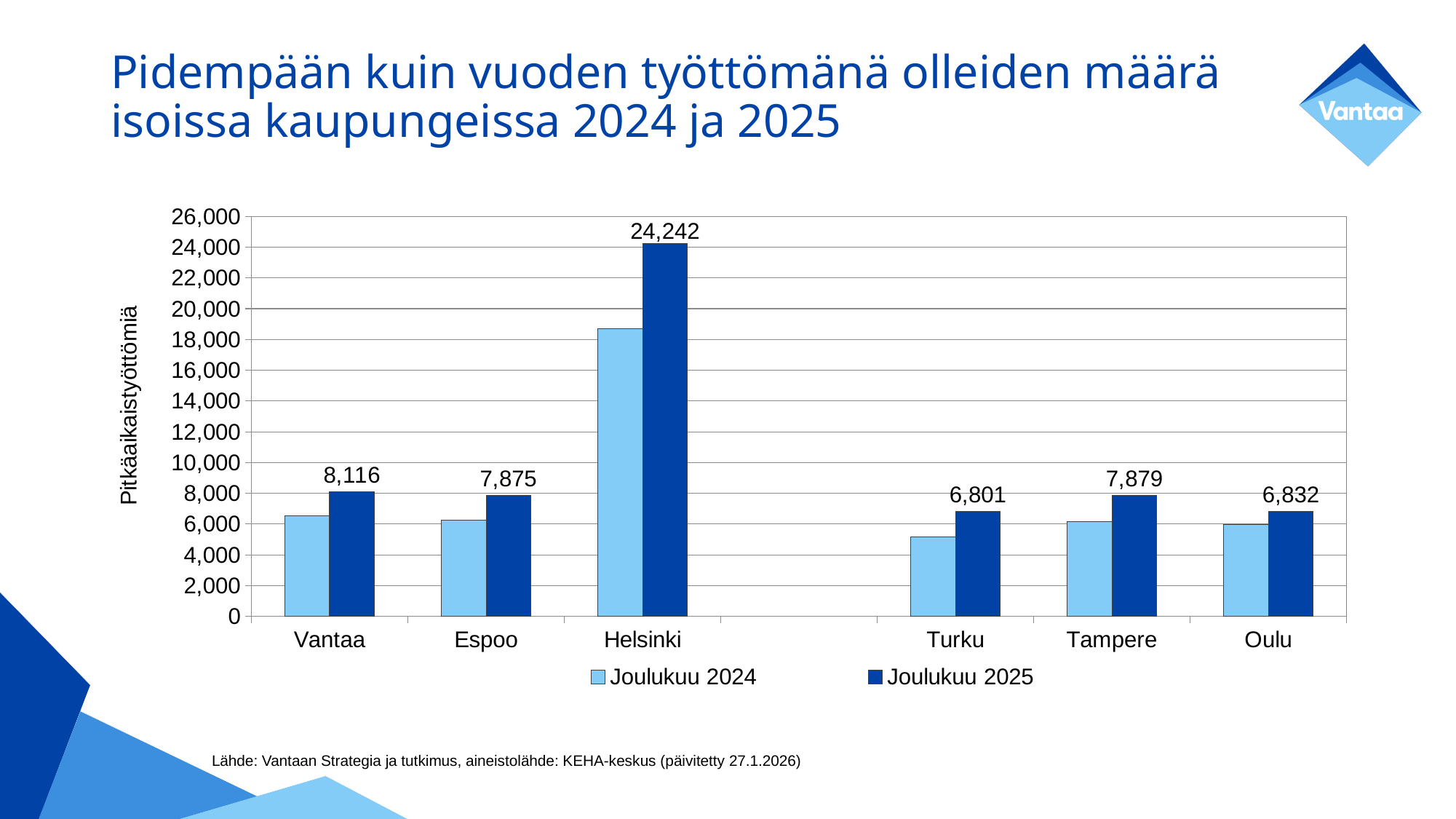
Which city has the lowest value in the Joulukuu 2025 series? Turku How many cities are shown on the x axis of the chart? 6 Is the Joulukuu 2024 value for Helsinki greater or less than 18,000? greater Which city has the highest value in the Joulukuu 2025 series? Helsinki What is the difference between the Joulukuu 2025 values for Helsinki and Vantaa? 16,126 Which is larger in the Joulukuu 2025 series, Tampere or Espoo? Tampere Is the Joulukuu 2024 value for Turku greater or less than 6,000? less What is the value for Helsinki in the Joulukuu 2025 series? 24,242 What is the difference between the Joulukuu 2025 values for Vantaa and Espoo? 241 How many series does the legend list? 2 What is the value for Turku in the Joulukuu 2025 series? 6,801 What is the value for Vantaa in the Joulukuu 2025 series? 8,116